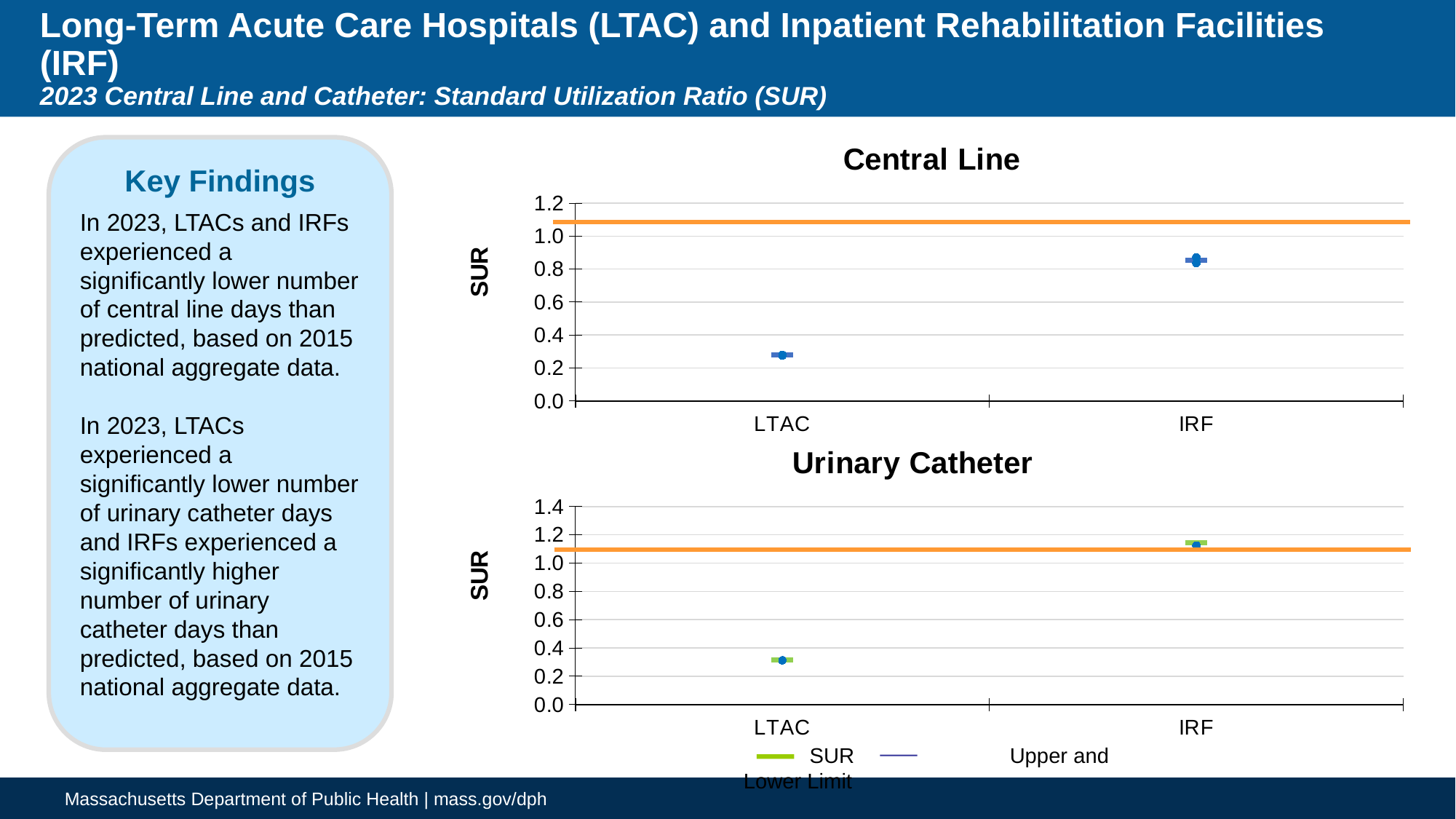
What is the title of the lower chart on the slide? Urinary Catheter In the Urinary Catheter chart, how many entries does the legend list? 2 In the Central Line chart, is the SUR value for IRF greater or less than 1.0? less In the Urinary Catheter chart, is the SUR value for LTAC greater or less than 0.4? less In the Urinary Catheter chart, which category has the higher SUR, LTAC or IRF? IRF In the Urinary Catheter chart, how many categories are shown on the x axis? 2 In the Central Line chart, which category has the higher SUR, LTAC or IRF? IRF In the Central Line chart, is the SUR value for IRF greater or less than 0.8? greater In the Central Line chart, which category has the lowest SUR? LTAC What is the y-axis label on the Central Line chart? SUR